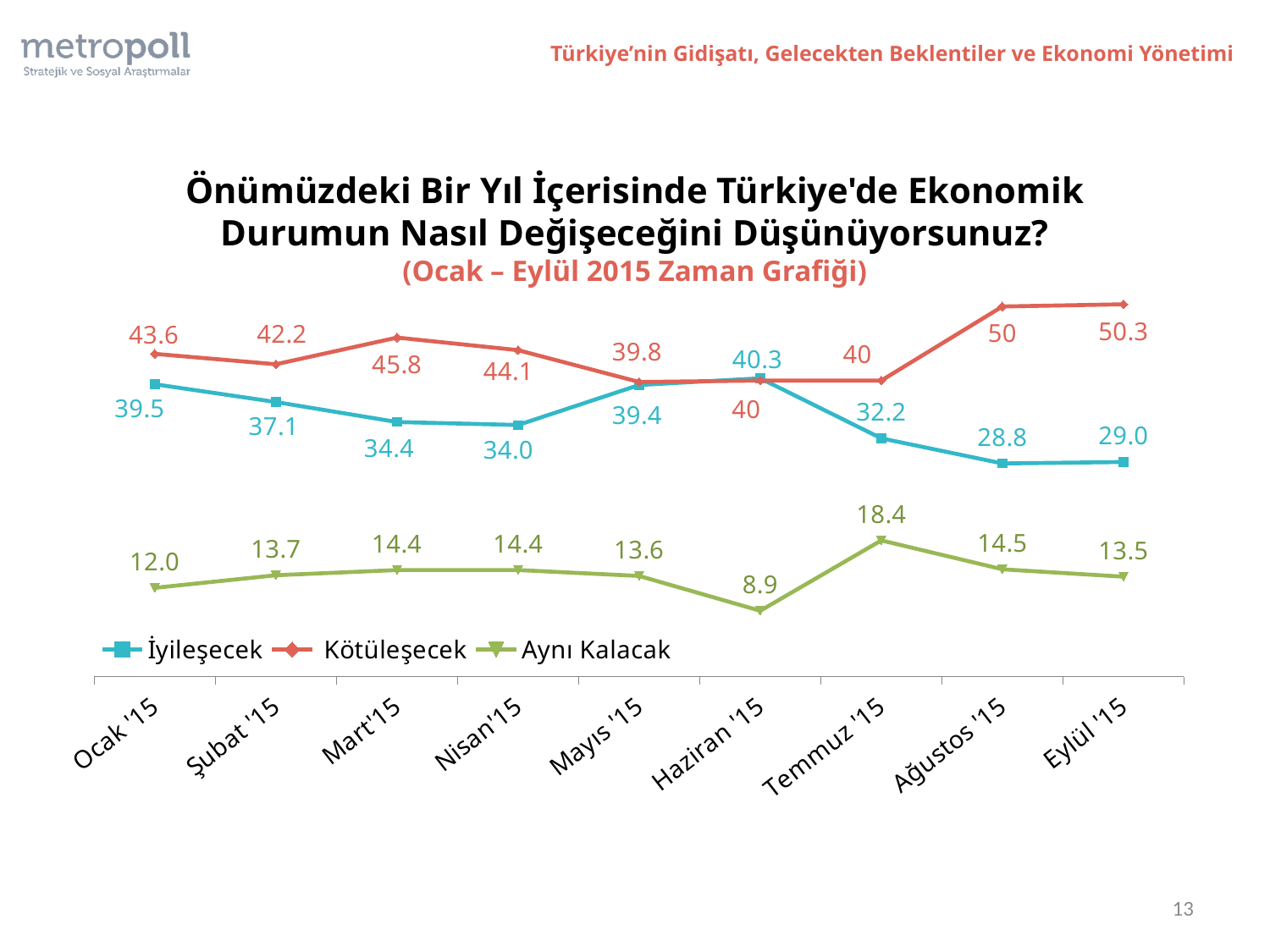
What is the difference between Kötüleşecek and İyileşecek in Ağustos '15? 21.2 What is the value for Kötüleşecek in Eylül '15? 50.3 How many series does the legend list? 3 What is the value for İyileşecek in Ağustos '15? 28.8 In which month does Kötüleşecek reach its highest value? Eylül '15 How many months are shown on the x axis? 9 What is the value for Aynı Kalacak in Temmuz '15? 18.4 Which is larger in Haziran '15, İyileşecek or Kötüleşecek? İyileşecek In which month does Aynı Kalacak reach its lowest value? Haziran '15 What is the value for İyileşecek in Ocak '15? 39.5 What kind of chart is shown on the slide? Line chart Does the İyileşecek series rise or fall from Haziran '15 to Ağustos '15? Fall